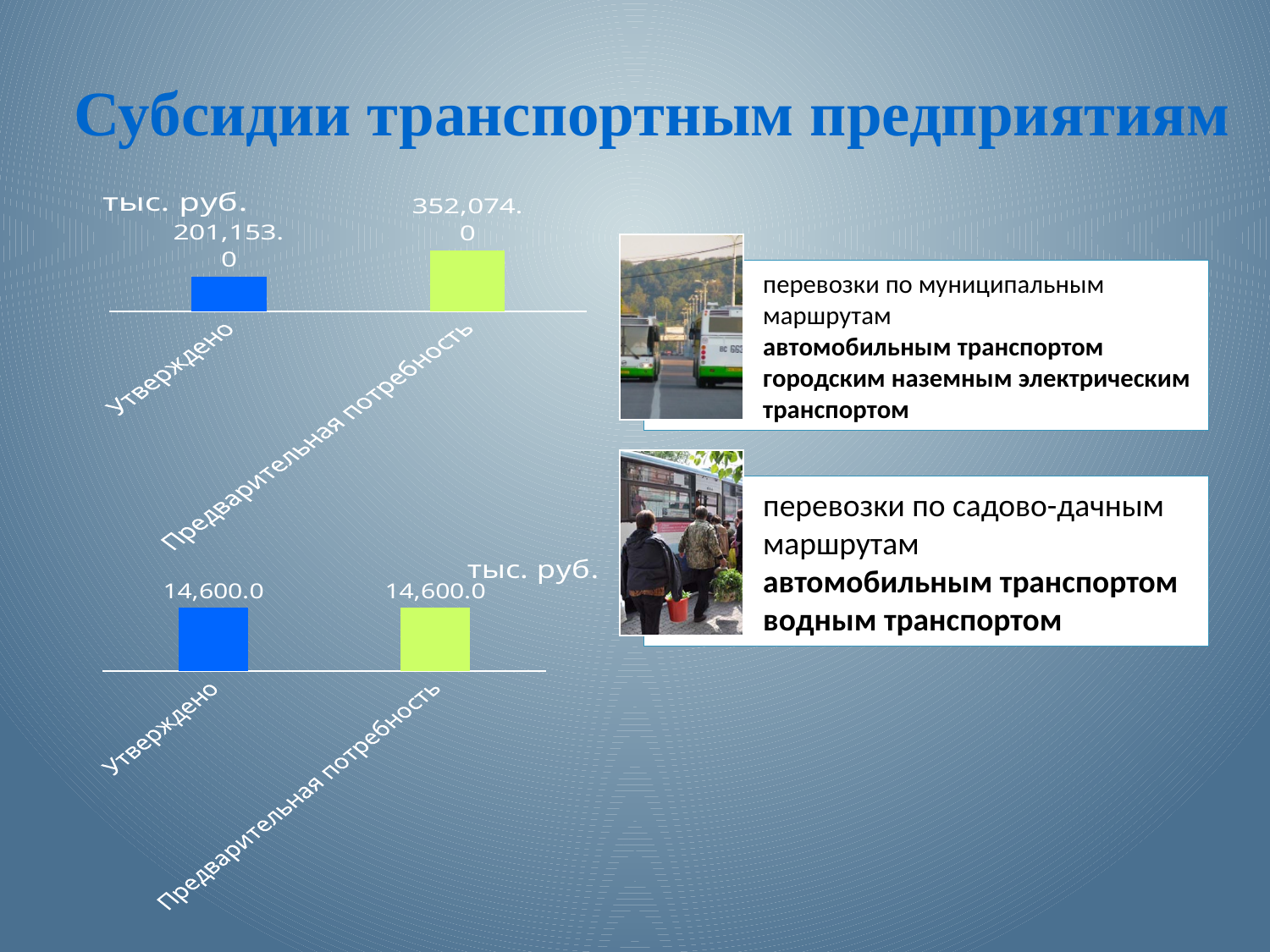
What unit is indicated on the charts? тыс. руб. In the bottom chart, what is the difference between Предварительная потребность and Утверждено? 0.0 In the top chart, what is the value for Утверждено? 201,153.0 How many categories are shown in the top chart? 2 In the top chart, which category has the lower value? Утверждено In the top chart, is the value for Утверждено larger or smaller than the value for Предварительная потребность? smaller In the top chart, which category has the higher value? Предварительная потребность What type of chart is the top chart? bar chart In the top chart, what is the difference between Предварительная потребность and Утверждено? 150,921.0 In the bottom chart, what is the value for Утверждено? 14,600.0 In the top chart, what is the value for Предварительная потребность? 352,074.0 In the bottom chart, what is the value for Предварительная потребность? 14,600.0